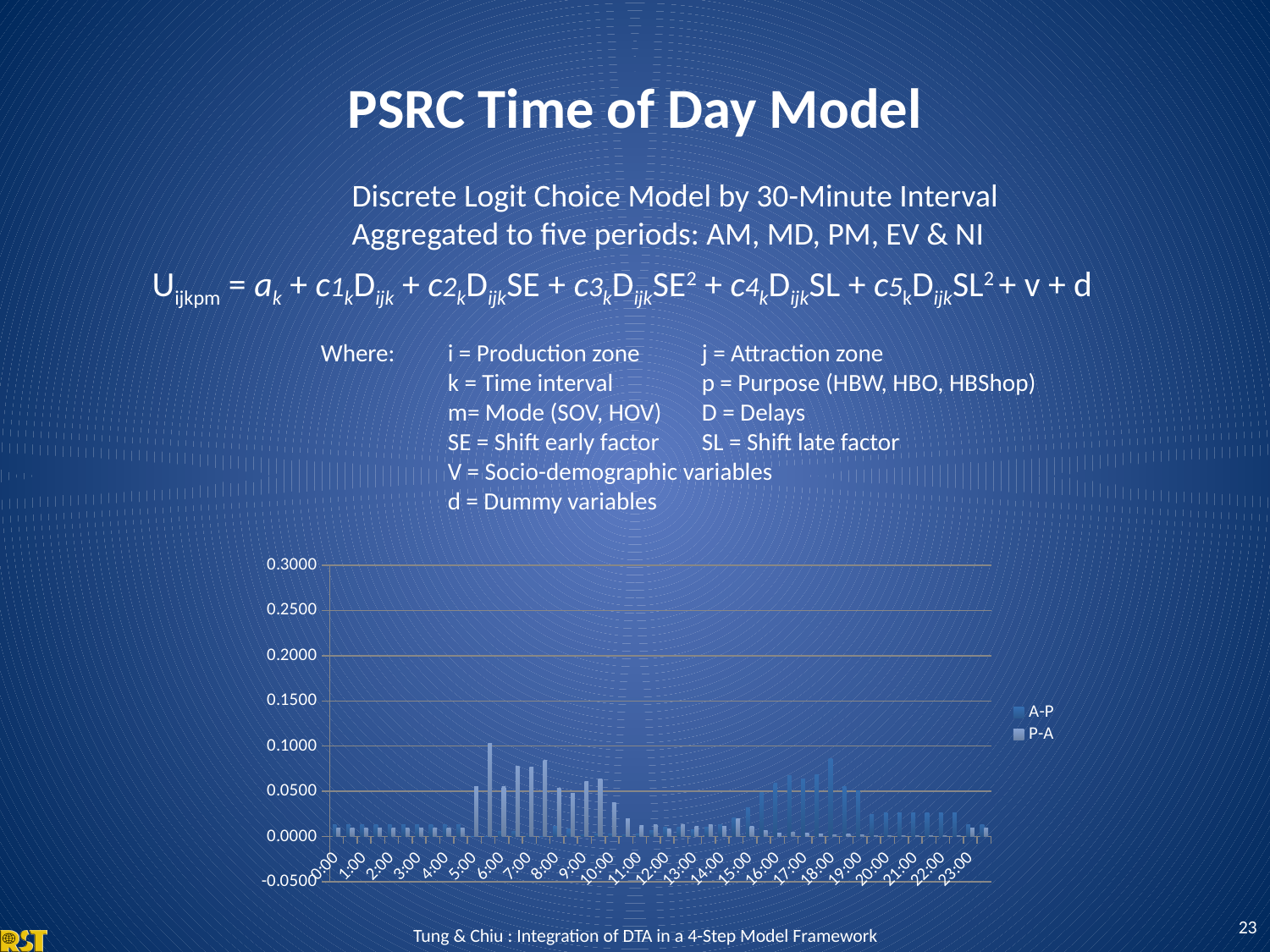
Is the tallest bar at 2:00 greater or less than 0.0500? less Is the tallest bar at 17:00 greater or less than 0.1000? less What are the two series named in the chart legend? A-P and P-A How many series does the chart legend list? 2 What is the highest value shown on the chart's y axis? 0.3000 Between 0:00 and 6:00, do the bar heights generally rise or fall? rise How many hour labels are shown along the x axis of the chart? 24 What kind of chart is shown at the bottom of the slide? bar chart Between 18:00 and 23:00, do the bar heights generally rise or fall? fall Is the tallest bar at 12:00 greater or less than 0.0500? less